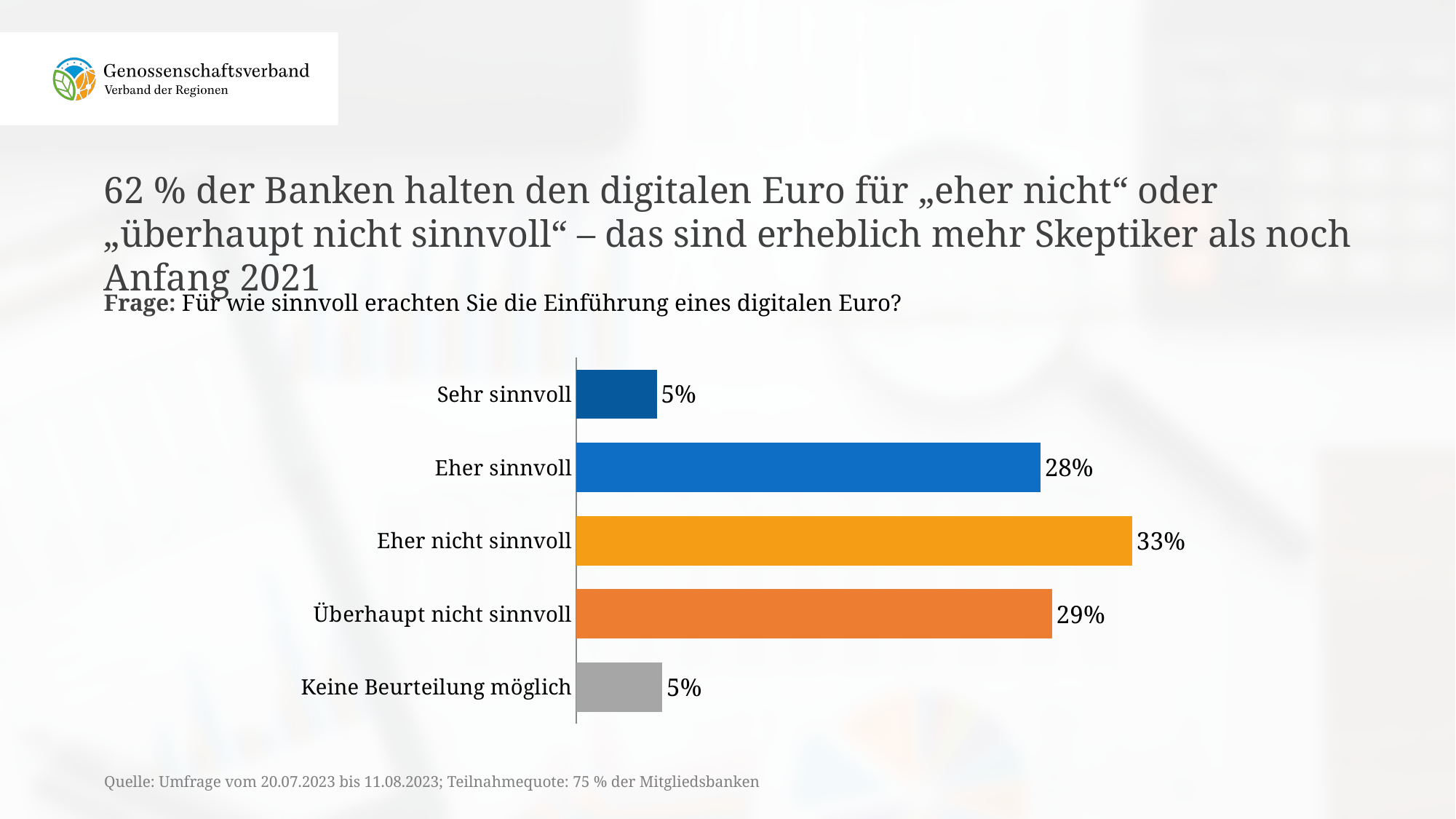
Which is larger, "Eher sinnvoll" or "Überhaupt nicht sinnvoll"? Überhaupt nicht sinnvoll What is the combined value of "Eher nicht sinnvoll" and "Überhaupt nicht sinnvoll"? 62% What is the value for "Sehr sinnvoll"? 5% What is the value for "Überhaupt nicht sinnvoll"? 29% Which category has the highest value? Eher nicht sinnvoll What colour is the bar for "Keine Beurteilung möglich"? Grey What is the value for "Eher sinnvoll"? 28% How many categories are shown in the chart? 5 What is the value for "Eher nicht sinnvoll"? 33% What kind of chart is shown on the slide? Bar chart What is the difference between "Überhaupt nicht sinnvoll" and "Sehr sinnvoll"? 24% What is the difference between "Eher nicht sinnvoll" and "Eher sinnvoll"? 5%